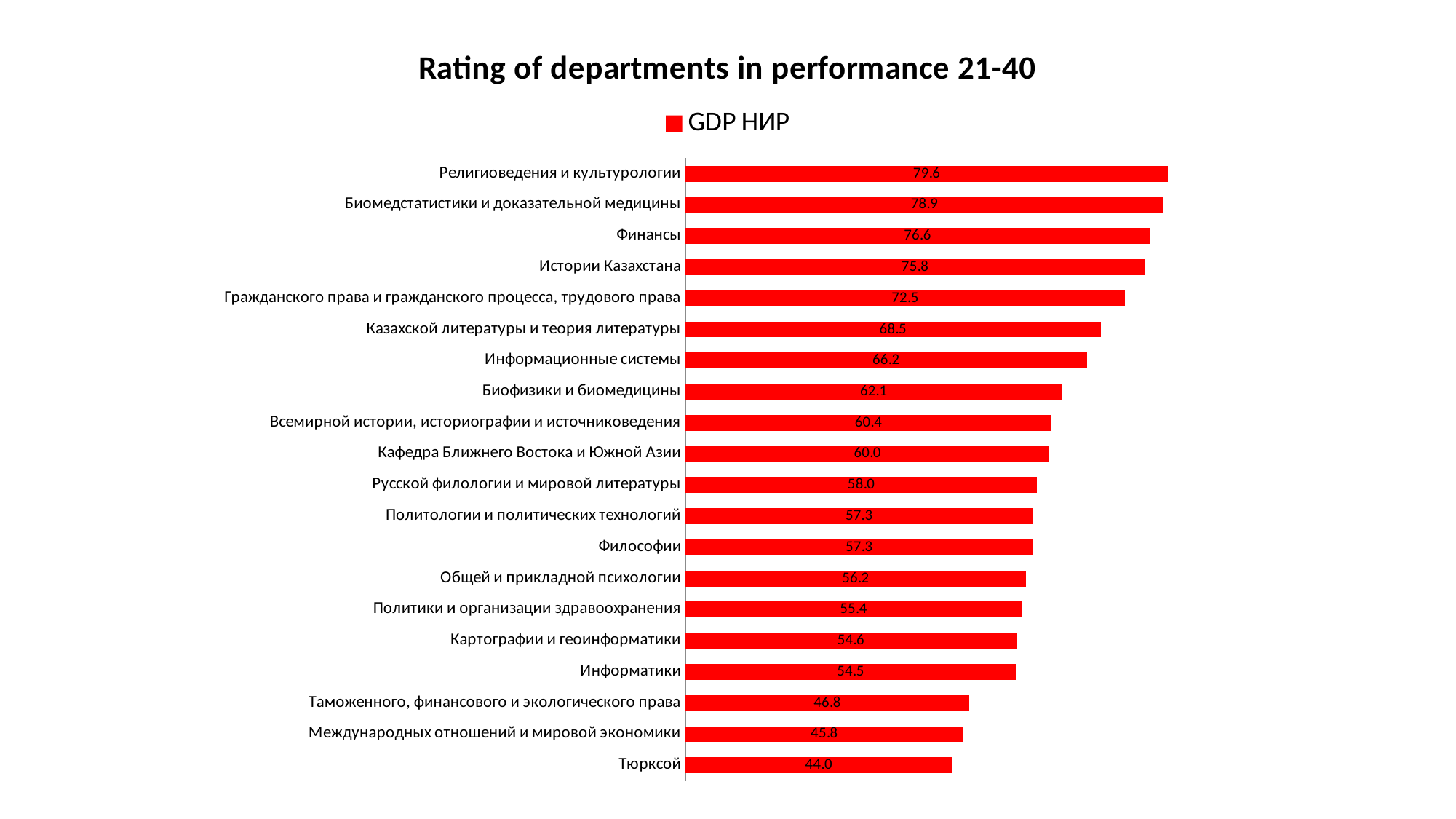
What kind of chart is shown on the slide? Bar chart Which department has the lowest value? Тюрксой How many series does the legend list? 1 Which is larger, the value for Казахской литературы и теория литературы or the value for Информатики? Казахской литературы и теория литературы What is the value for Информационные системы? 66.2 What is the title of the chart? Rating of departments in performance 21-40 How many departments are shown in the chart? 20 What is the value for Финансы? 76.6 What is the difference between the values for Религиоведения и культурологии and Тюрксой? 35.6 Which department has the highest value? Религиоведения и культурологии What is the difference between the values for Истории Казахстана and Биофизики и биомедицины? 13.7 What is the value for Тюрксой? 44.0